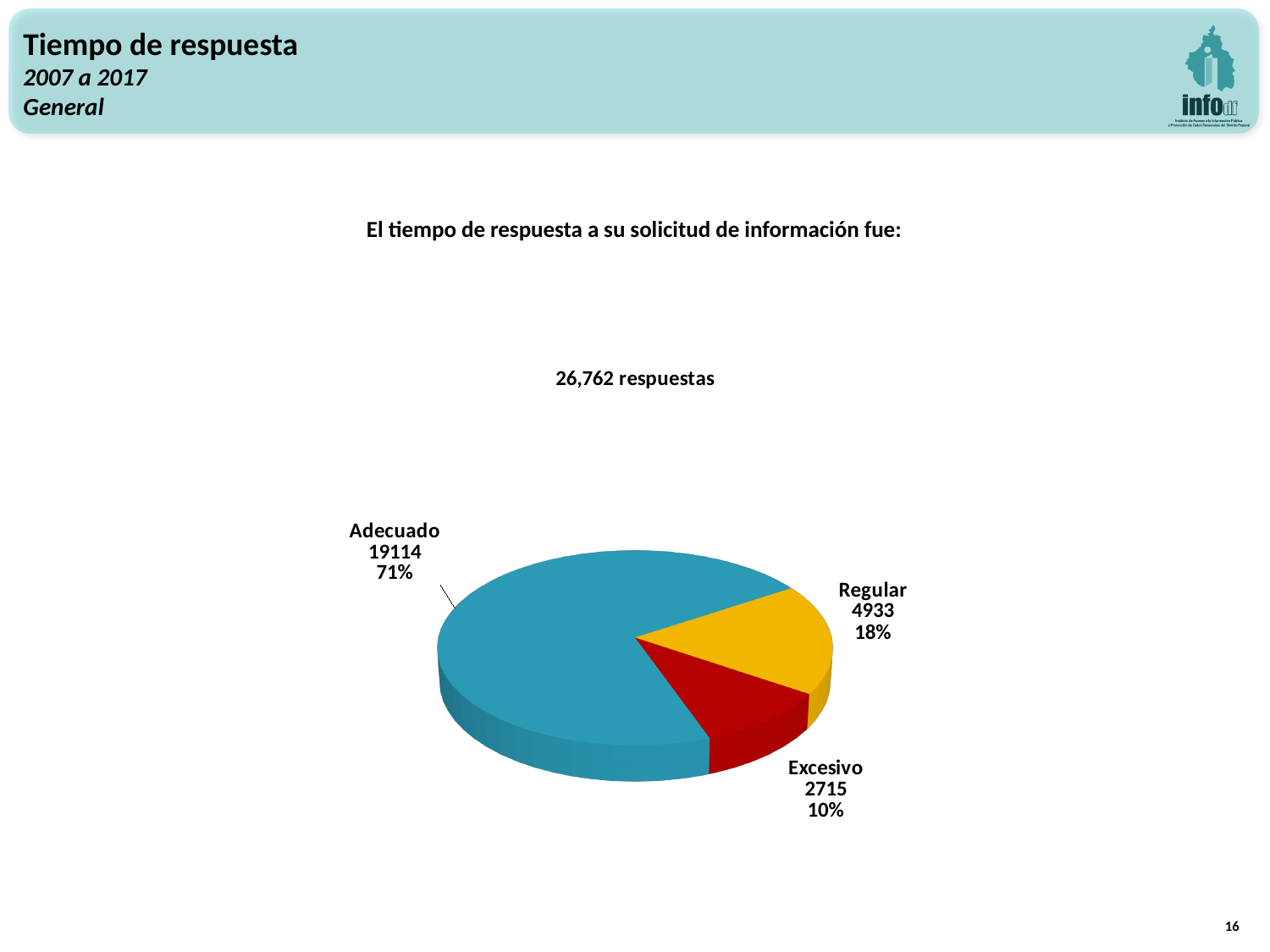
Which category has the smallest slice? Excesivo What is the difference between the values for Regular and Excesivo? 2218 Which is larger, the value for Regular or the value for Excesivo? Regular Which category has the largest slice? Adecuado What is the value for Excesivo? 2715 What is the value for Regular? 4933 What is the value for Adecuado? 19114 What share of the pie does Excesivo represent? 10% What kind of chart is shown on the slide? Pie chart How many slices does the pie chart have? 3 What share of the pie does Adecuado represent? 71% What total number of responses is stated above the chart? 26,762 respuestas